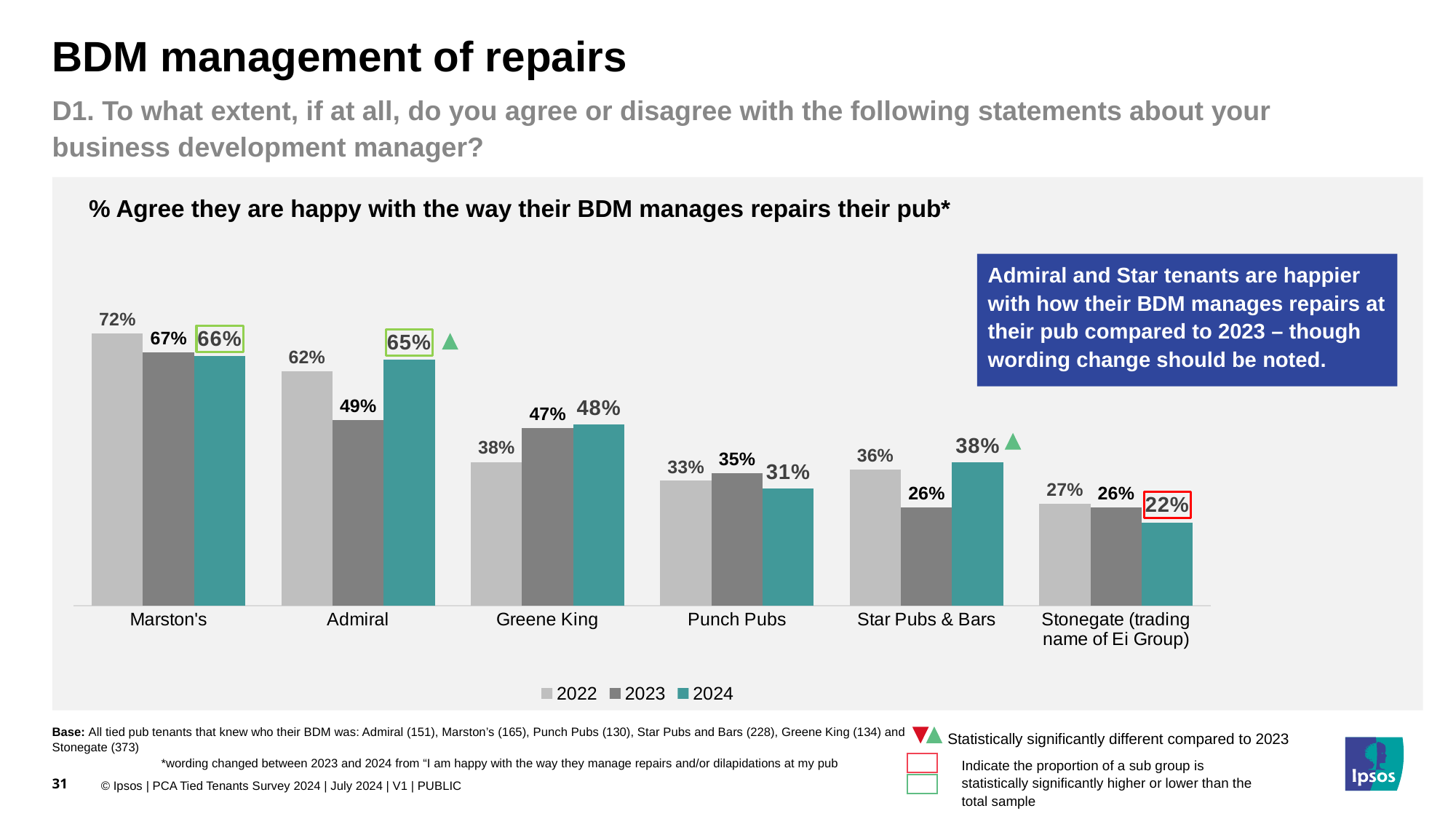
What is the 2024 value for Stonegate (trading name of Ei Group)? 22% Which pub company has the lowest 2023 value? Star Pubs & Bars and Stonegate (trading name of Ei Group), tied at 26% Did the value for Star Pubs & Bars rise or fall from 2023 to 2024? Rise What is the 2024 value for Admiral? 65% What is the 2022 value for Marston's? 72% Which is larger for Punch Pubs: the 2023 value or the 2024 value? 2023 How many series does the legend list? 3 What kind of chart is shown on the slide? Bar chart What is the difference between the 2024 and 2023 values for Admiral? 16 percentage points How many pub companies are shown on the x axis? 6 Which pub company has the highest 2024 value? Marston's What is the 2023 value for Star Pubs & Bars? 26%